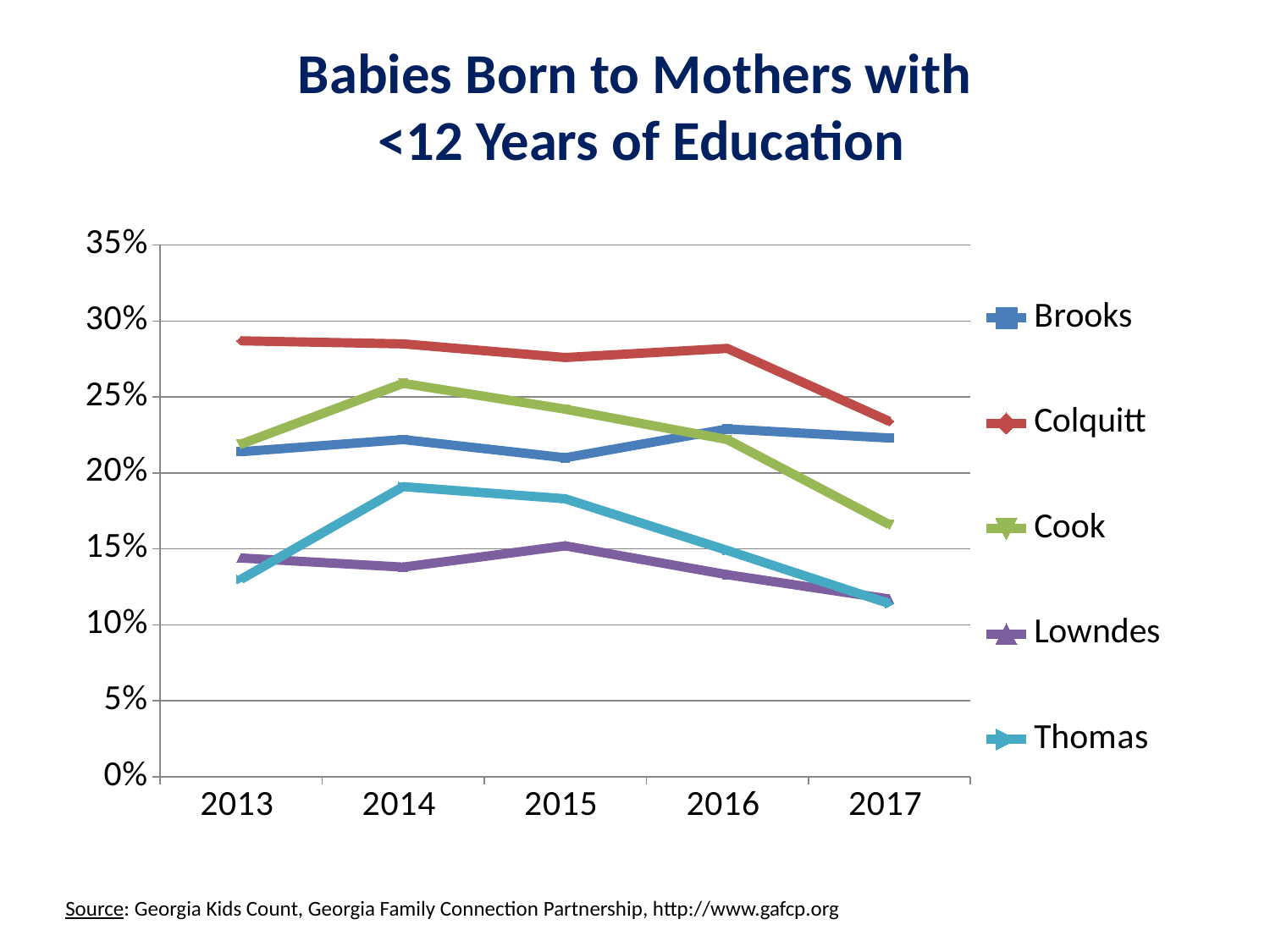
Is the value for Thomas in 2014 greater or less than 15%? greater How many series does the legend list? 5 In 2014, which is larger, the value for Cook or the value for Brooks? Cook What is the title of the chart? Babies Born to Mothers with <12 Years of Education How many years are shown on the x axis? 5 Does the value for Colquitt rise or fall from 2016 to 2017? fall Is the value for Colquitt in 2013 greater or less than 25%? greater What kind of chart is shown on the slide? line chart Is the value for Cook in 2017 greater or less than 20%? less Which county has the highest value in 2013? Colquitt Which county has the lowest value in 2014? Lowndes